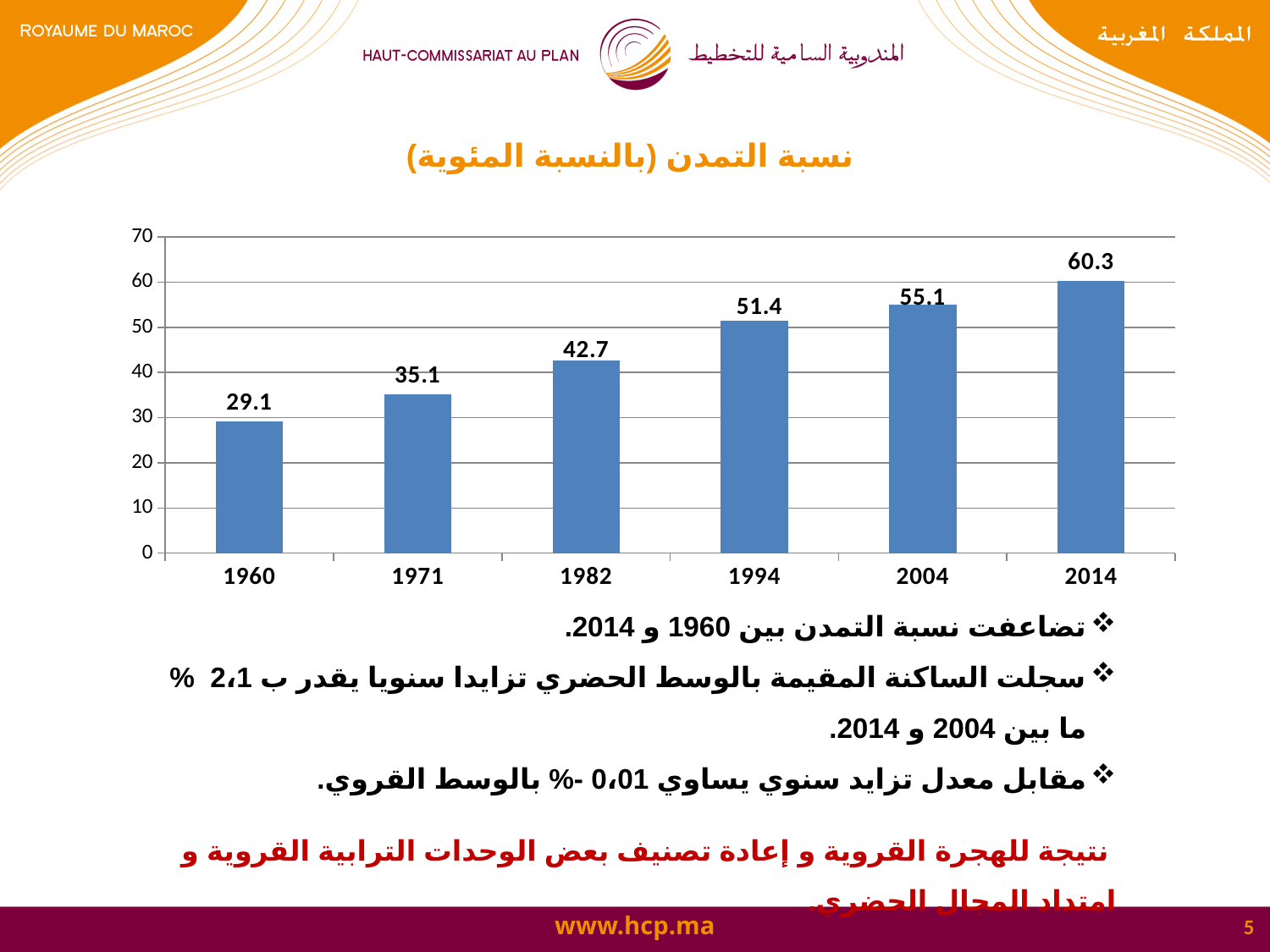
Is the value for 1982 greater or less than 40? greater Which year has the highest value in the chart? 2014 Which is larger, the value for 1982 or the value for 1971? 1982 What is the urbanization rate shown for 1960? 29.1 Which year has the lowest value in the chart? 1960 What value is shown for 1994? 51.4 Do the values rise or fall from 1960 to 2014? rise What is the difference between the values for 2014 and 1960? 31.2 What kind of chart is shown on the slide? bar chart What is the difference between the values for 2004 and 1994? 3.7 What value is shown for 2014? 60.3 How many years are shown on the x axis of the chart? 6